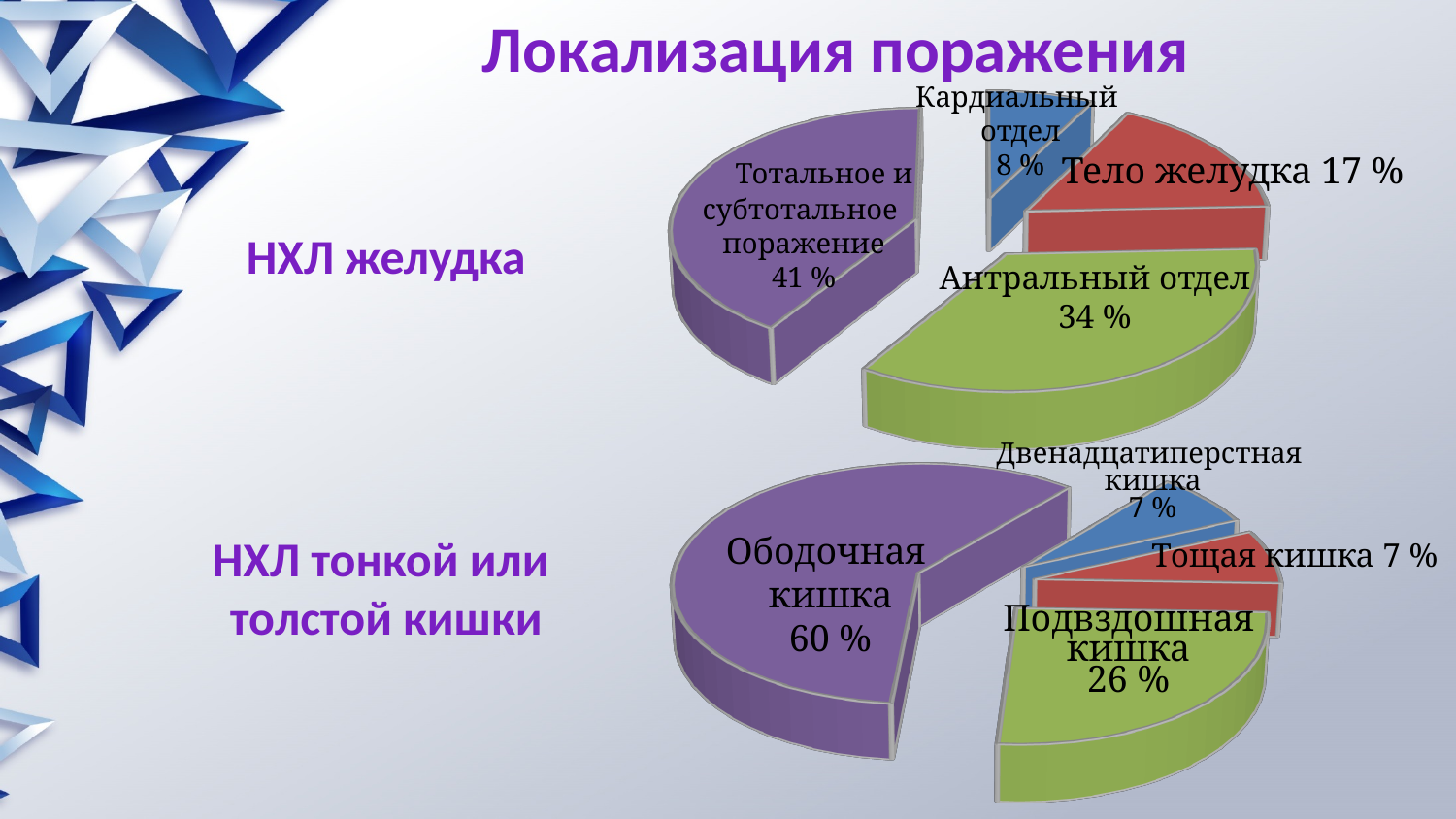
What type of chart is used for both charts on the slide? Pie chart In the bottom chart (НХЛ тонкой или толстой кишки), what is the difference between Ободочная кишка and Подвздошная кишка? 34 % In the bottom chart (НХЛ тонкой или толстой кишки), what is the value for Подвздошная кишка? 26 % In the bottom chart (НХЛ тонкой или толстой кишки), what is the value for Ободочная кишка? 60 % In the bottom chart (НХЛ тонкой или толстой кишки), which category has the largest share? Ободочная кишка In the top chart (НХЛ желудка), what is the value for Кардиальный отдел? 8 % In the top chart (НХЛ желудка), which category has the largest share? Тотальное и субтотальное поражение In the top chart (НХЛ желудка), what is the difference between Антральный отдел and Тело желудка? 17 % In the bottom chart (НХЛ тонкой или толстой кишки), which is larger: Подвздошная кишка or Тощая кишка? Подвздошная кишка In the top chart (НХЛ желудка), how many slices does the pie have? 4 In the top chart (НХЛ желудка), what is the value for Антральный отдел? 34 % In the top chart (НХЛ желудка), which category has the smallest share? Кардиальный отдел